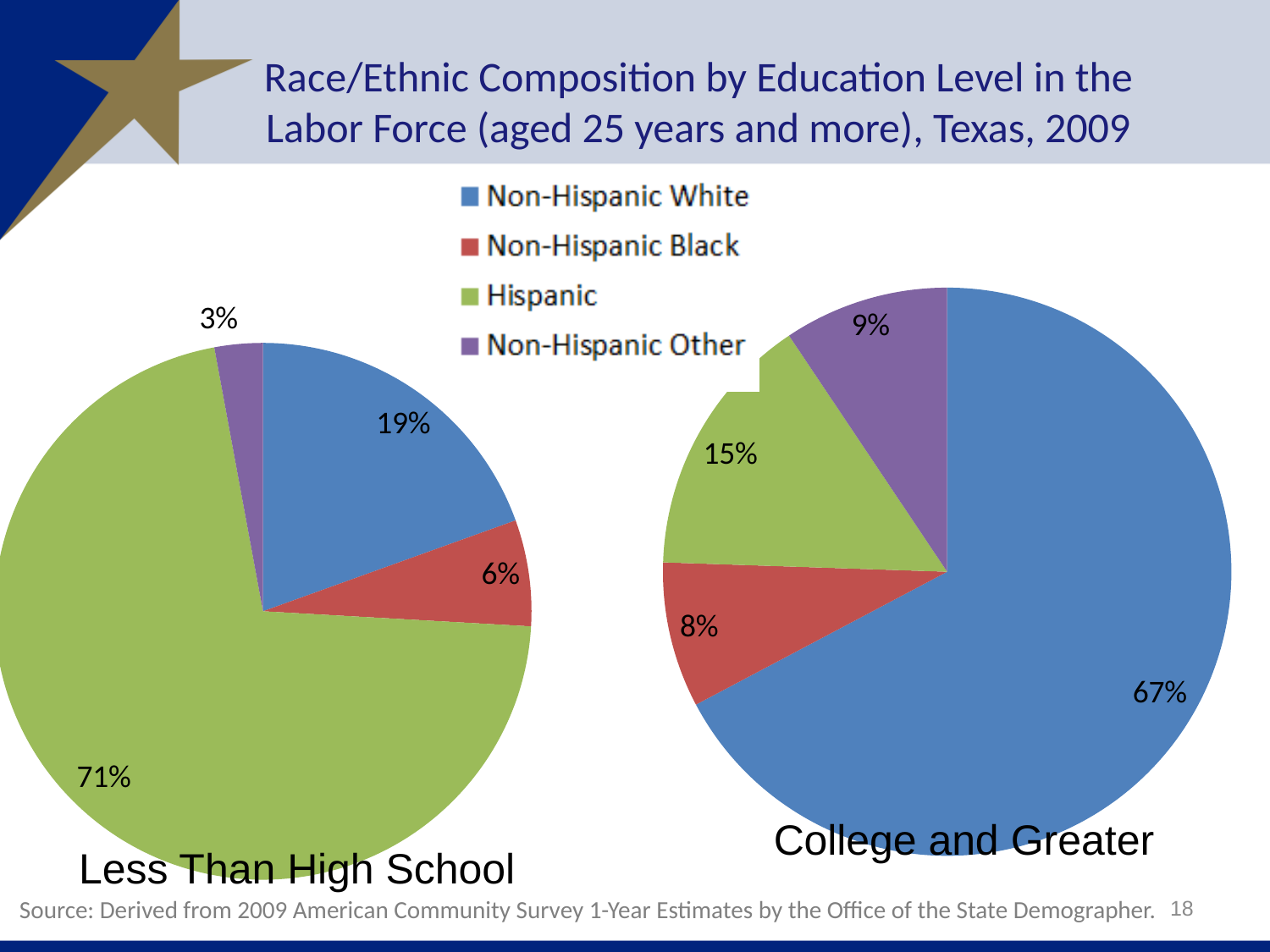
Which colour represents Hispanic in the legend? Green In the Less Than High School chart, which group has the largest share? Hispanic In the College and Greater chart, what share is Non-Hispanic Other? 9% In the Less Than High School chart, which group has the smallest share? Non-Hispanic Other How many groups does the legend list? 4 What is the difference between the Non-Hispanic White share in the College and Greater chart and in the Less Than High School chart? 48 percentage points In the Less Than High School chart, what share is Non-Hispanic Black? 6% In the College and Greater chart, which is larger: the Hispanic share or the Non-Hispanic Black share? Hispanic In the College and Greater chart, which group has the smallest share? Non-Hispanic Black In the College and Greater chart, what share is Non-Hispanic White? 67% In the Less Than High School chart, what share is Hispanic? 71% What type of chart is the Less Than High School chart? Pie chart